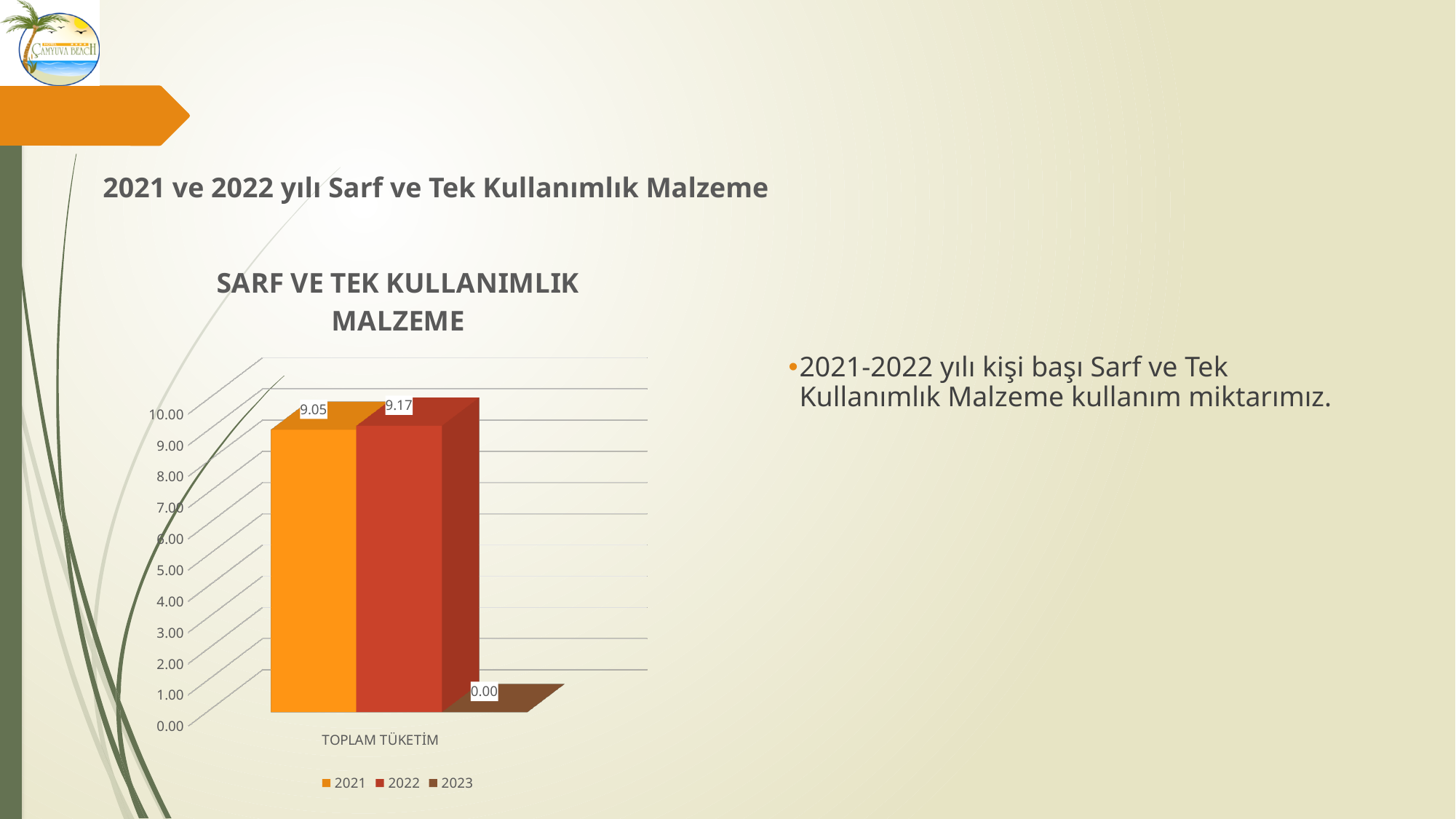
What is the category label on the x axis of the SARF VE TEK KULLANIMLIK MALZEME chart? TOPLAM TÜKETİM What is the value for 2021 in the SARF VE TEK KULLANIMLIK MALZEME chart? 9.05 What is the difference between the 2022 and 2021 values in the SARF VE TEK KULLANIMLIK MALZEME chart? 0.12 Which series has the highest value in the SARF VE TEK KULLANIMLIK MALZEME chart? 2022 How many series does the legend list in the SARF VE TEK KULLANIMLIK MALZEME chart? 3 What is the value for 2022 in the SARF VE TEK KULLANIMLIK MALZEME chart? 9.17 What kind of chart is the SARF VE TEK KULLANIMLIK MALZEME chart? bar chart How many categories are shown on the x axis of the SARF VE TEK KULLANIMLIK MALZEME chart? 1 Is the value for 2021 greater or less than 9.00 in the SARF VE TEK KULLANIMLIK MALZEME chart? greater What is the title of the chart on the slide? SARF VE TEK KULLANIMLIK MALZEME What is the value for 2023 in the SARF VE TEK KULLANIMLIK MALZEME chart? 0.00 Which series has the lowest value in the SARF VE TEK KULLANIMLIK MALZEME chart? 2023